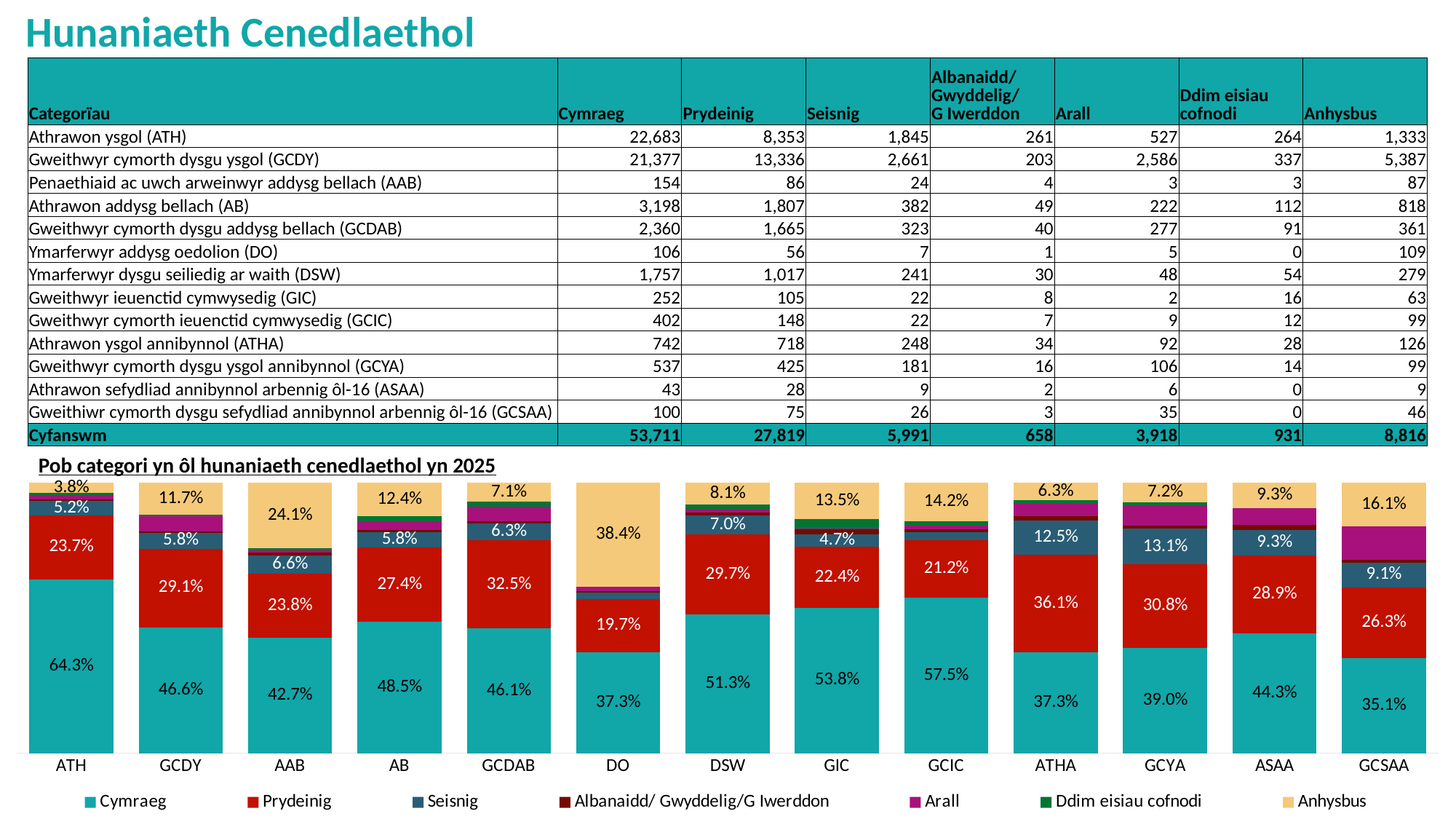
What is the Anhysbus share for DO in the chart? 38.4% What is the Cymraeg share for ATH in the chart? 64.3% What is the Prydeinig share for GCDAB in the chart? 32.5% In the chart, what is the difference between the Cymraeg share and the Prydeinig share for ATH? 40.6 percentage points What is the Seisnig share for ATHA in the chart? 12.5% How many categories are shown along the x axis of the chart? 13 Which category has the highest Prydeinig share in the chart? ATHA What kind of chart is shown under the heading 'Pob categori yn ôl hunaniaeth cenedlaethol yn 2025'? Stacked bar chart Which category has the highest Cymraeg share in the chart? ATH How many series does the chart legend list? 7 Which category has the lowest Cymraeg share in the chart? GCSAA In the chart, which is larger: the Anhysbus share for AAB or the Anhysbus share for GCSAA? AAB